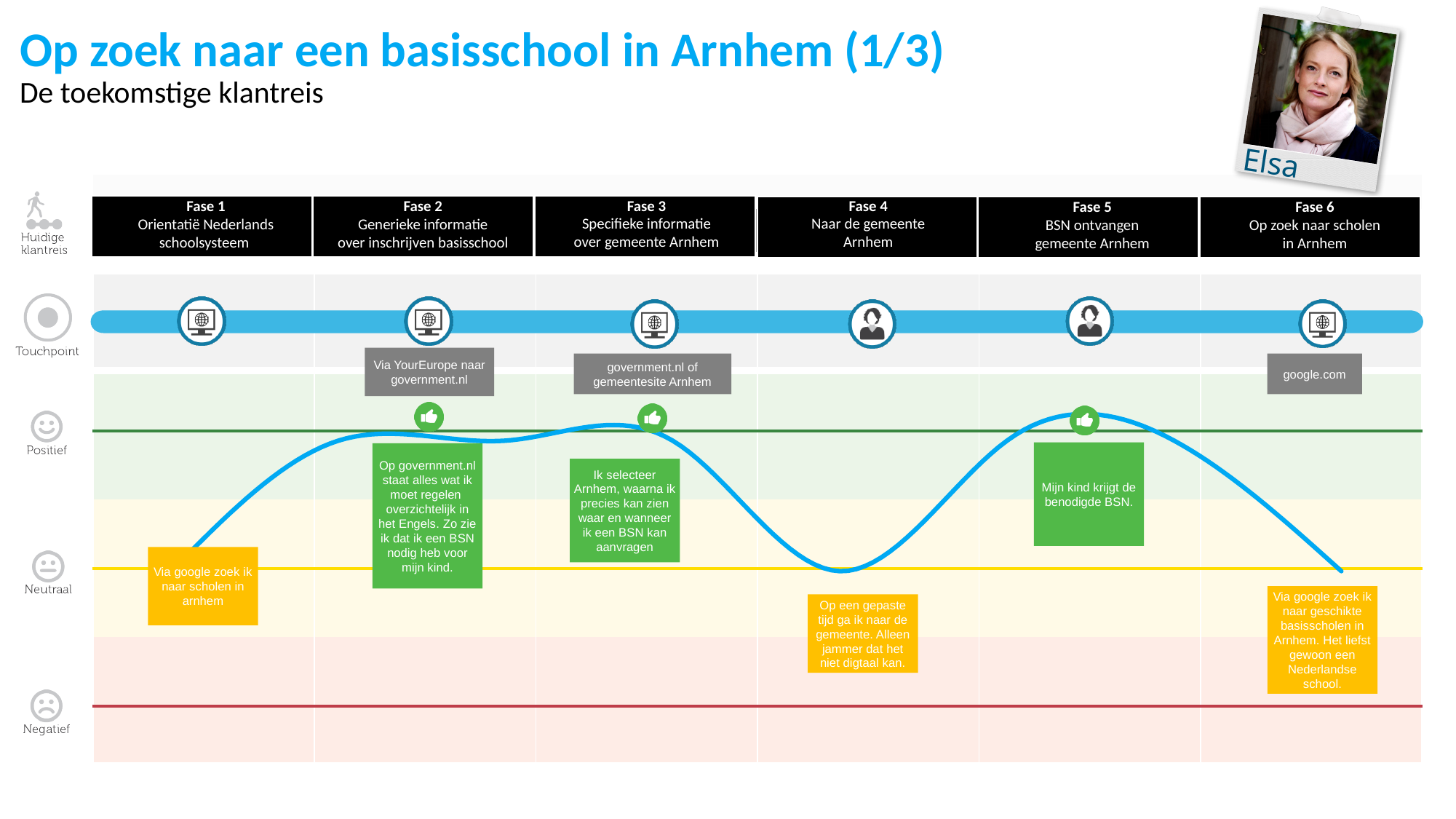
Does the emotion curve rise or fall from Fase 5 to Fase 6? fall Does the emotion curve rise or fall from Fase 1 to Fase 2? rise Does the emotion curve rise or fall from Fase 3 to Fase 4? fall In which phase does the emotion curve reach its highest point? Fase 5 How many emotion levels are labelled on the left side of the chart (Positief, Neutraal, Negatief)? 3 What is the title of the slide containing the customer journey chart? Op zoek naar een basisschool in Arnhem (1/3) Which phase has a higher position on the emotion curve, Fase 5 or Fase 6? Fase 5 What touchpoint label is shown under the icon for Fase 6? google.com How many touchpoint icons are placed on the blue touchpoint bar? 6 How many phases (fases) are shown along the top of the customer journey chart? 6 Which phase has a higher position on the emotion curve, Fase 2 or Fase 4? Fase 2